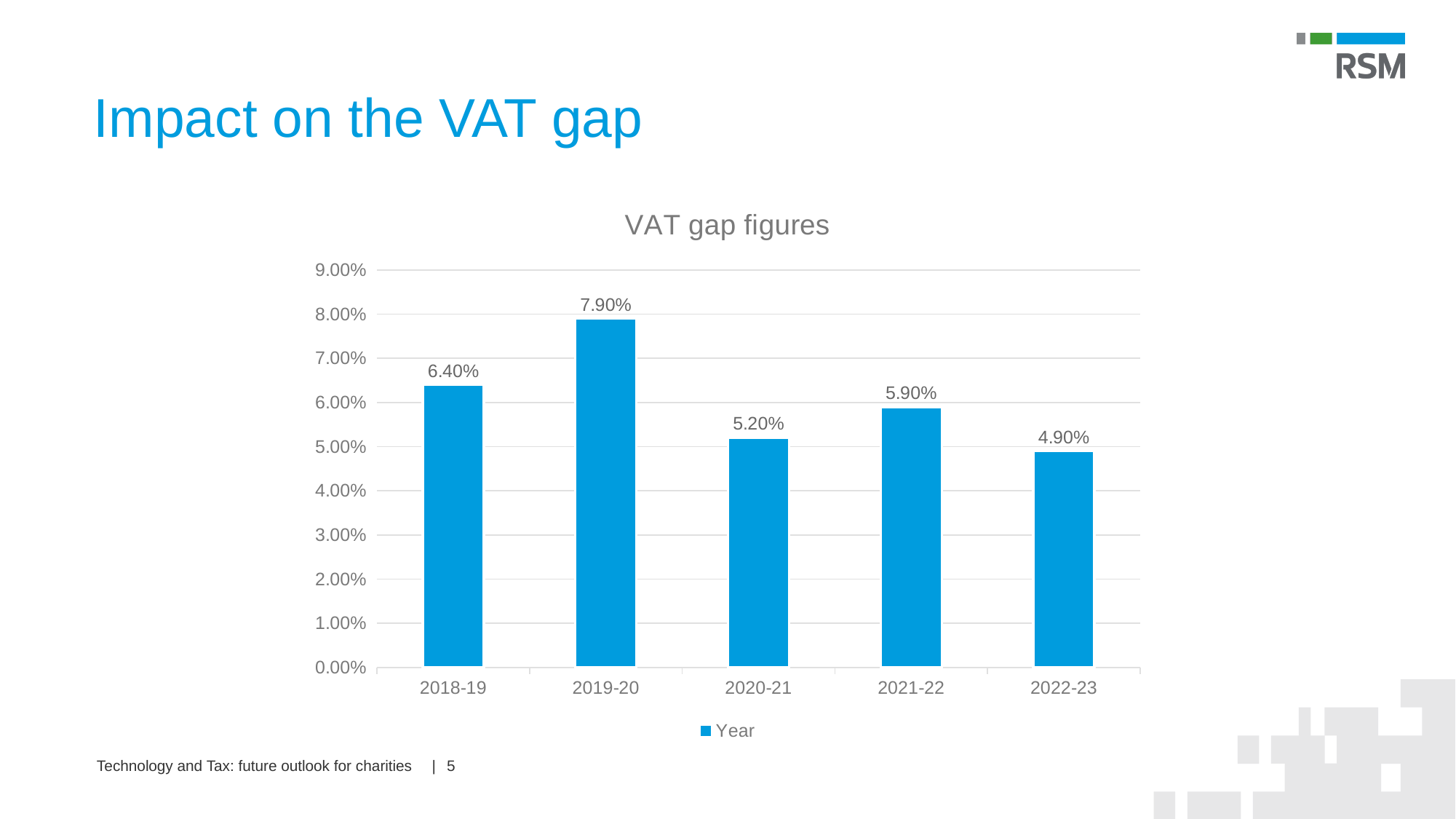
What is the VAT gap figure for 2019-20? 7.90% How many years are shown on the chart? 5 What type of chart is shown on the slide? bar chart Is the VAT gap figure for 2021-22 greater or less than 6.00%? less What is the difference between the VAT gap figures for 2019-20 and 2020-21? 2.70% What is the difference between the VAT gap figures for 2018-19 and 2021-22? 0.50% Which year has the highest VAT gap figure? 2019-20 Which is larger, the VAT gap figure for 2020-21 or for 2021-22? 2021-22 Which year has the lowest VAT gap figure? 2022-23 What is the title of the chart? VAT gap figures What is the VAT gap figure for 2022-23? 4.90% What is the VAT gap figure for 2018-19? 6.40%